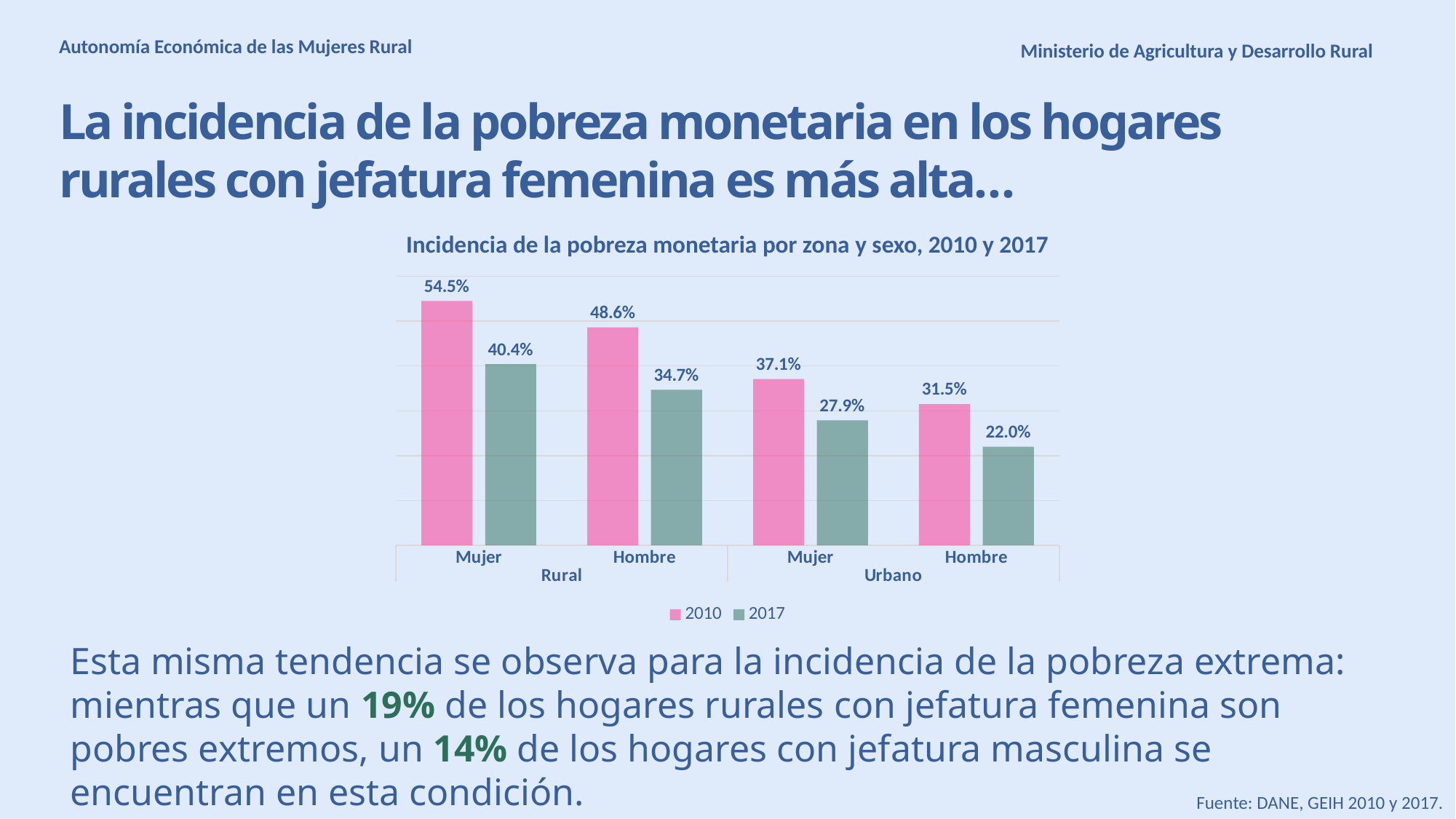
Which is larger: the 2017 value for Hombre in the Rural zone or the 2010 value for Mujer in the Urbano zone? 2010 Mujer Urbano (37.1%) Which category has the highest value in the 2010 series? Mujer (Rural) Which category has the lowest value in the 2017 series? Hombre (Urbano) How many bars are plotted in the chart? 8 What is the difference between the 2010 and 2017 values for Mujer in the Rural zone? 14.1% What is the title of the chart? Incidencia de la pobreza monetaria por zona y sexo, 2010 y 2017 How many series does the legend list? 2 What is the value for Mujer in the Urbano zone for 2017? 27.9% What is the value for Mujer in the Rural zone for 2010? 54.5% What is the value for Hombre in the Urbano zone for 2017? 22.0% What kind of chart is shown on the slide? Bar chart What is the difference between Mujer and Hombre in the Rural zone for 2017? 5.7%